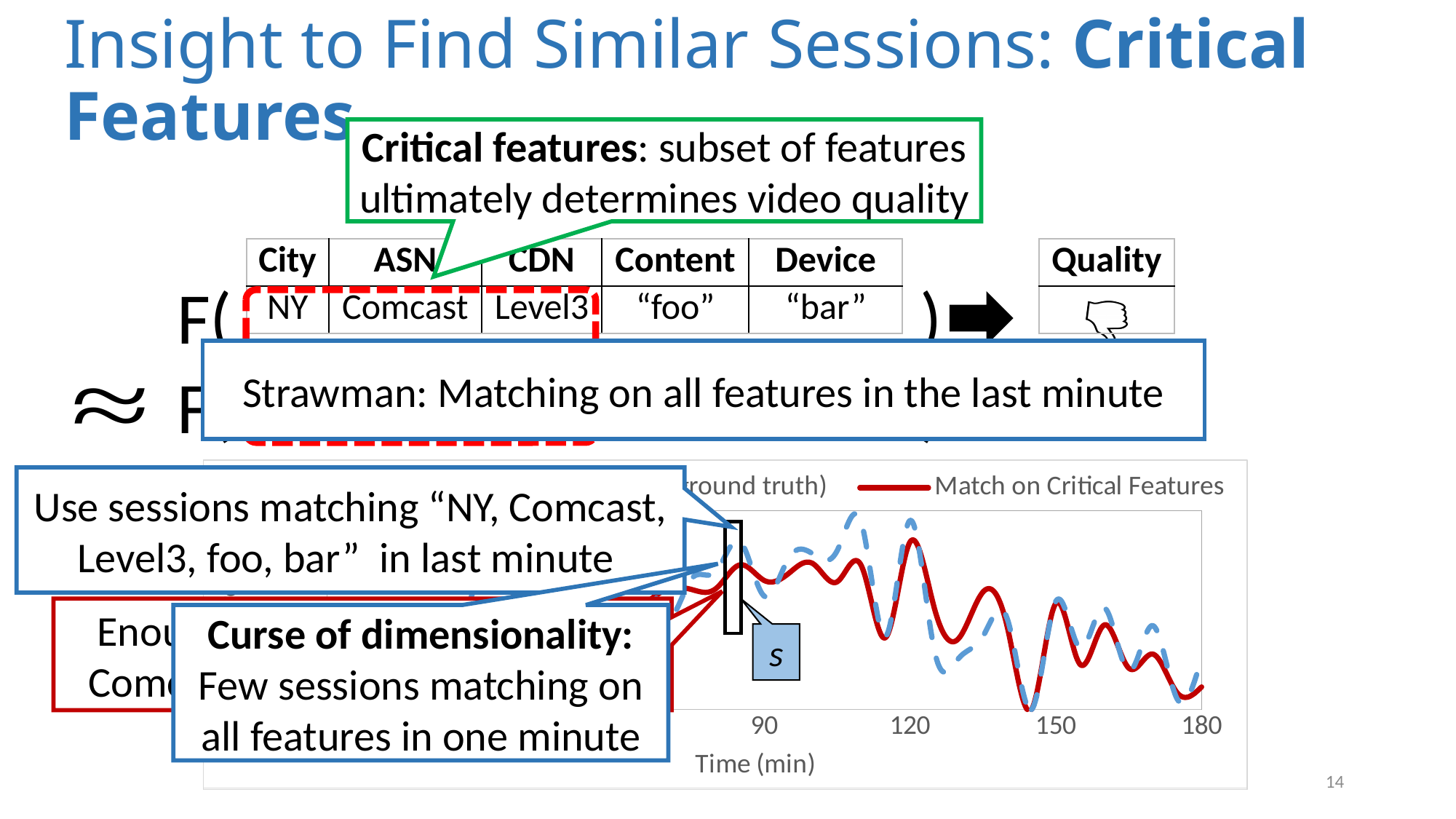
In the line chart, does the 'Match on Critical Features' line generally rise or fall between 120 and 180 minutes? fall How many series are plotted in the line chart at the bottom of the slide? 2 What is the label of the x axis of the line chart? Time (min) In the line chart, what legend entry corresponds to the solid red line? Match on Critical Features What kind of chart is shown at the bottom of the slide? line chart